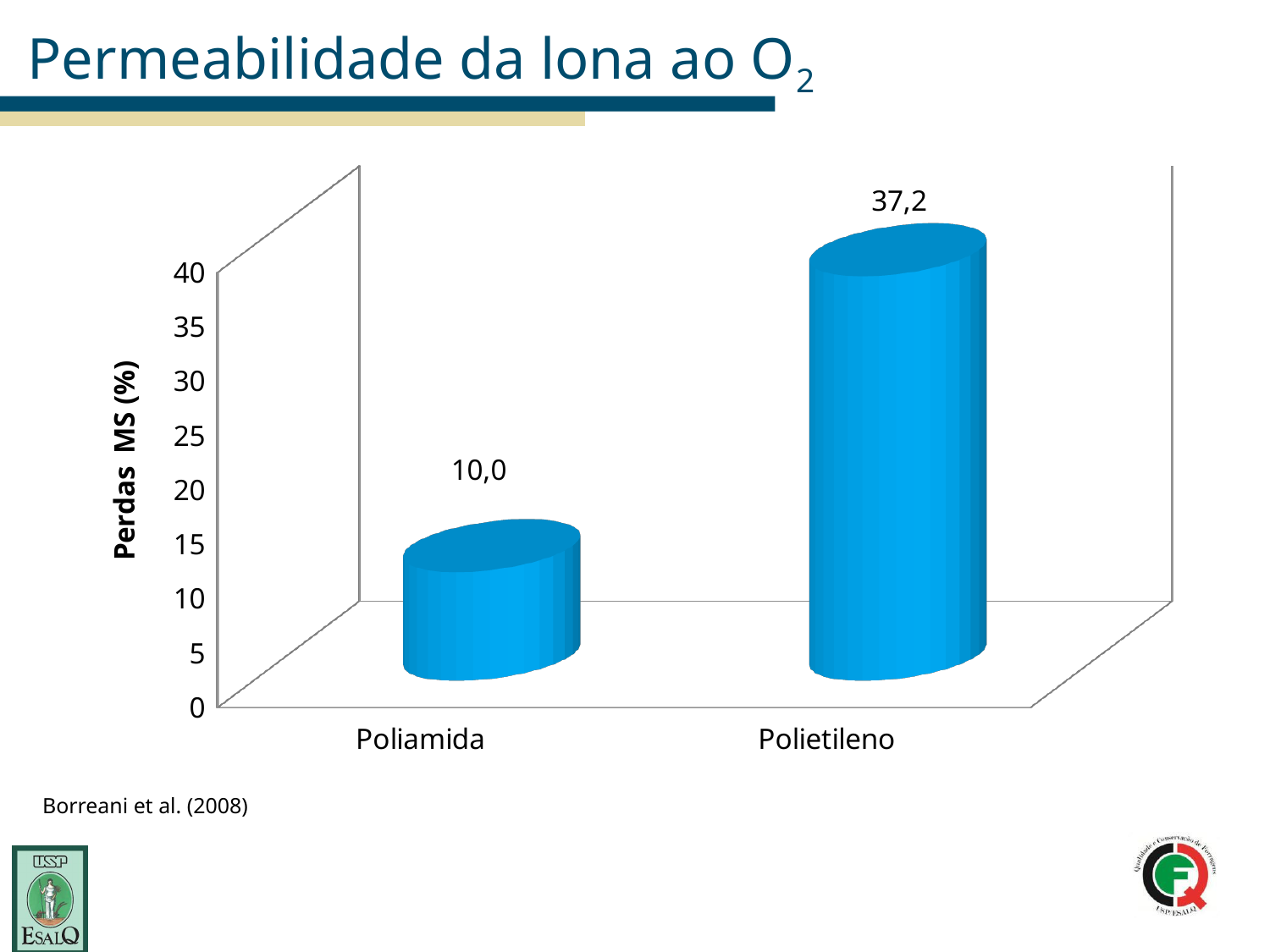
Is the value for Polietileno greater or less than 30? greater What is the label of the vertical axis? Perdas MS (%) Is the value for Poliamida greater or less than 15? less Which category has the highest value? Polietileno What is the source cited below the chart? Borreani et al. (2008) How many categories are shown on the x axis? 2 What is the value for Poliamida? 10,0 Which is larger, the value for Poliamida or the value for Polietileno? Polietileno What is the value for Polietileno? 37,2 Which category has the lowest value? Poliamida What is the difference between the values for Polietileno and Poliamida? 27,2 What kind of chart is shown on the slide? bar chart